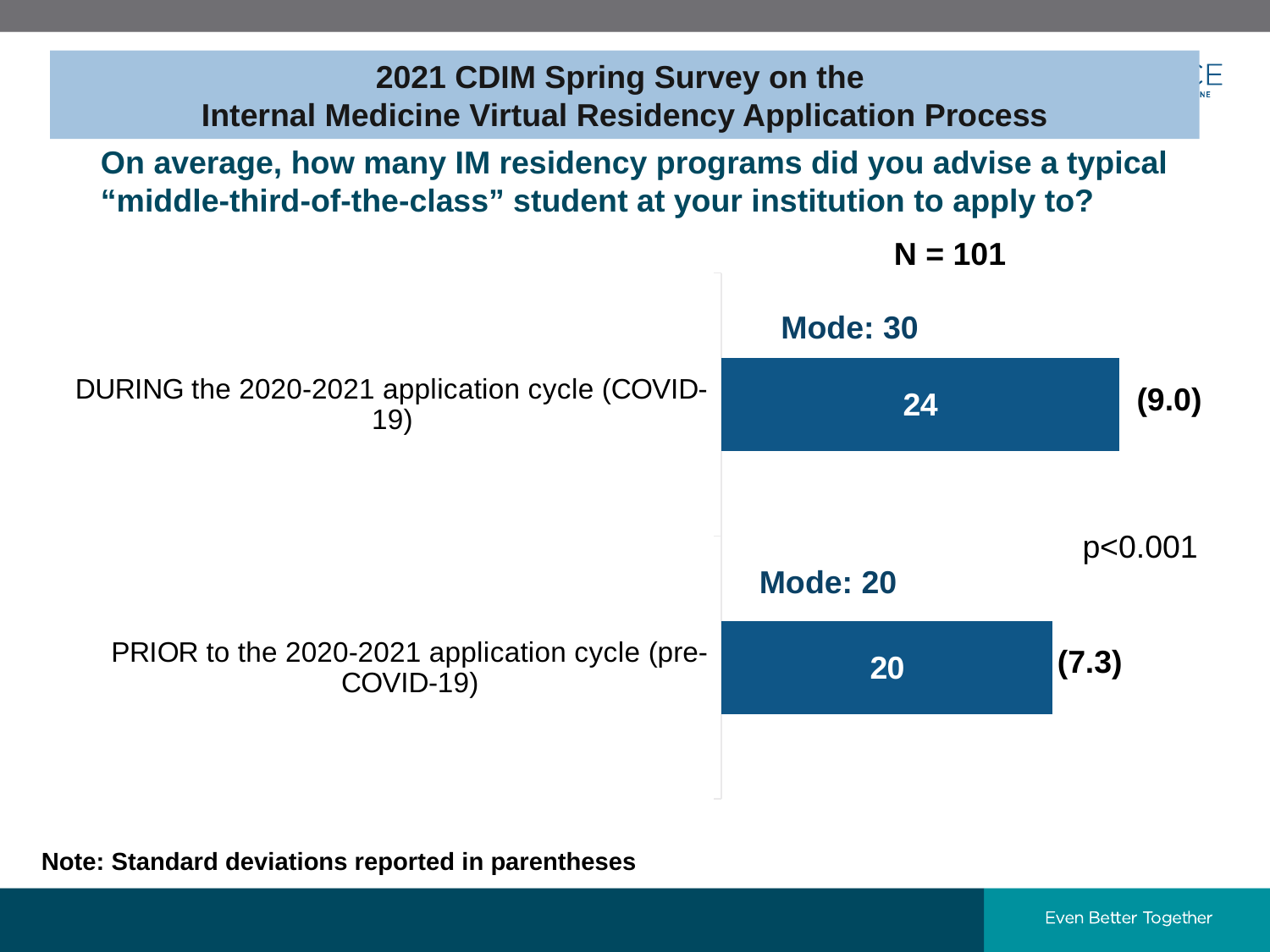
Which category has the lower average number of programs advised? PRIOR to the 2020-2021 application cycle (pre-COVID-19) Is the average for DURING the 2020-2021 application cycle larger or smaller than the average for PRIOR to the 2020-2021 application cycle? larger What is the standard deviation reported for DURING the 2020-2021 application cycle (COVID-19)? 9.0 What sample size (N) is shown on the chart? N = 101 How many categories are shown in the chart? 2 What is the mode reported for DURING the 2020-2021 application cycle (COVID-19)? 30 What is the average number of programs advised PRIOR to the 2020-2021 application cycle (pre-COVID-19)? 20 Which category has the higher average number of programs advised? DURING the 2020-2021 application cycle (COVID-19) What is the difference between the average for DURING the 2020-2021 cycle and the average for PRIOR to the 2020-2021 cycle? 4 What is the standard deviation reported for PRIOR to the 2020-2021 application cycle (pre-COVID-19)? 7.3 What kind of chart is shown on the slide? bar chart What is the average number of programs advised DURING the 2020-2021 application cycle (COVID-19)? 24